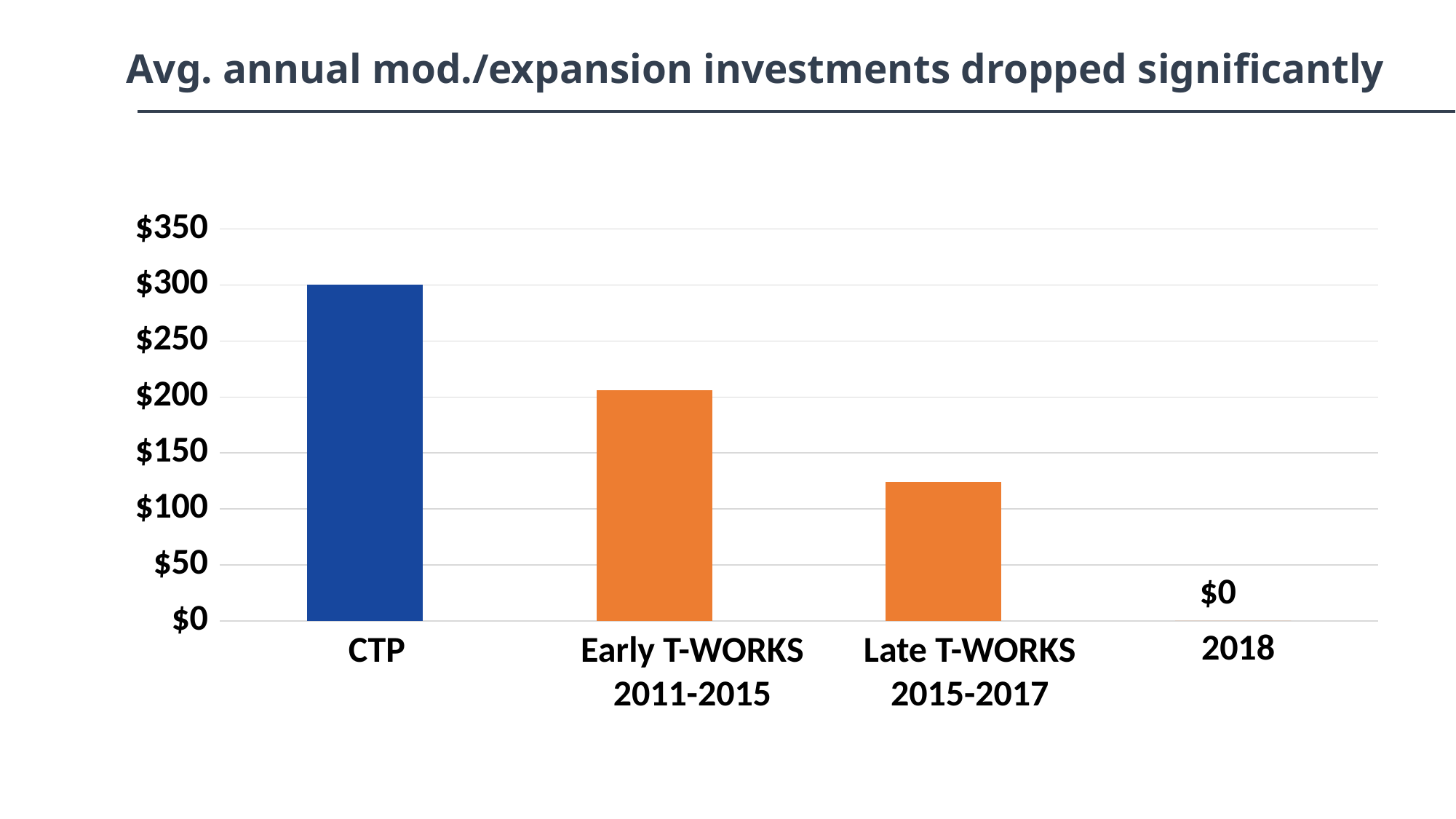
Which is larger, the value for Early T-WORKS 2011-2015 or Late T-WORKS 2015-2017? Early T-WORKS 2011-2015 What is the value of the CTP bar? $300 Which category has the highest value in the chart? CTP What kind of chart is shown on the slide? bar chart Which category has the lowest value in the chart? 2018 Is the value for Early T-WORKS 2011-2015 greater or less than $150? greater Do the values rise or fall from left to right across the categories? fall How many categories are shown on the x axis of the chart? 4 Is the value for Late T-WORKS 2015-2017 greater or less than $100? greater What is the value shown for 2018? $0 Is the value for Late T-WORKS 2015-2017 greater or less than $150? less What is the title of the chart? Avg. annual mod./expansion investments dropped significantly